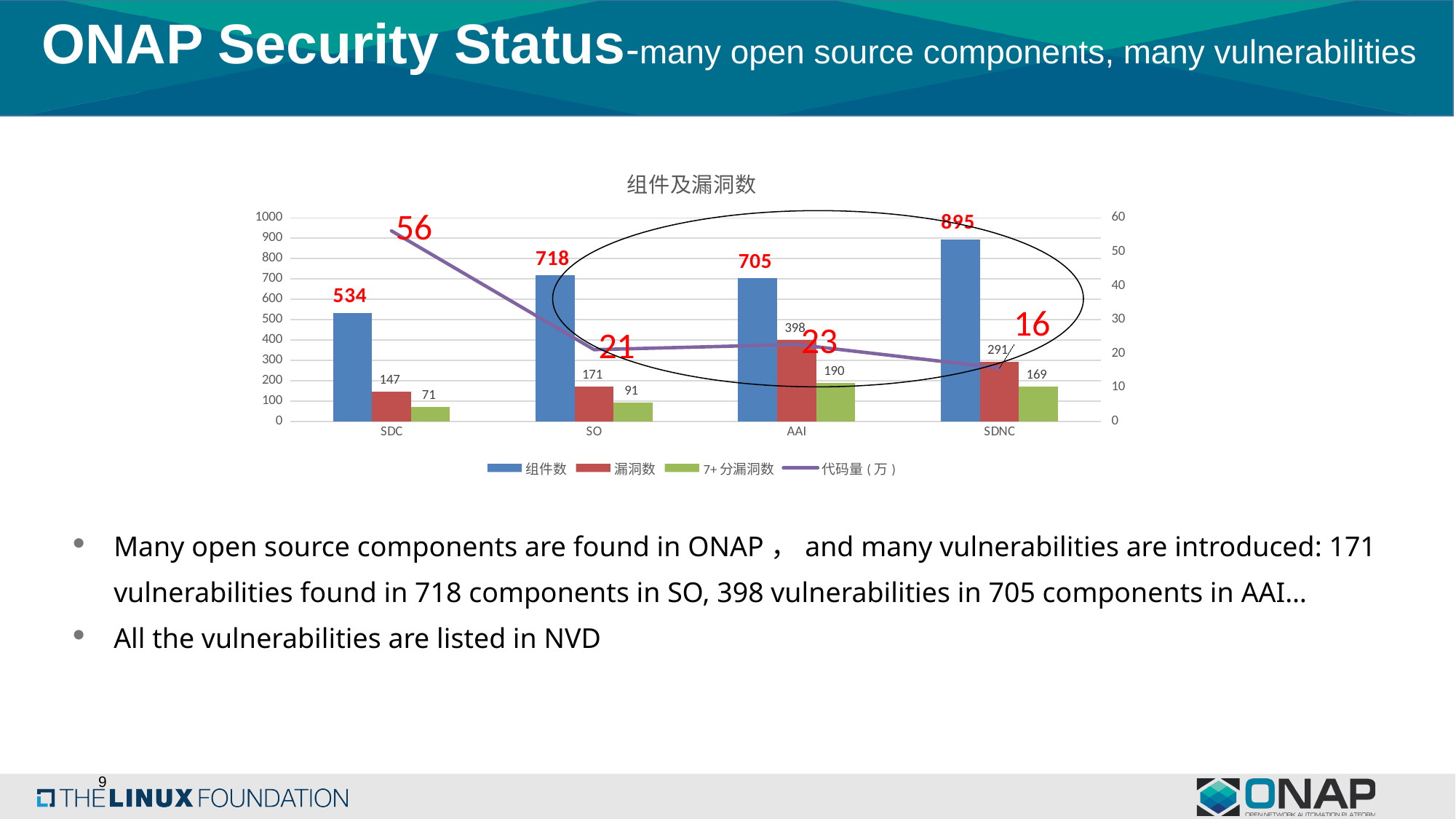
What is the 代码量（万） value for SDC? 56 How many categories are shown on the x axis? 4 Which category has the lowest 7+分漏洞数? SDC What is the title of the chart? 组件及漏洞数 What is the difference between the 组件数 for SDNC and SDC? 361 What is the 漏洞数 value for AAI? 398 How many series does the legend list? 4 What is the 7+分漏洞数 value for SO? 91 Which is larger, the 漏洞数 for AAI or for SDNC? AAI Does the 代码量（万） line rise or fall from SDC to SO? fall Which category has the highest 组件数? SDNC What is the 组件数 value for SDNC? 895